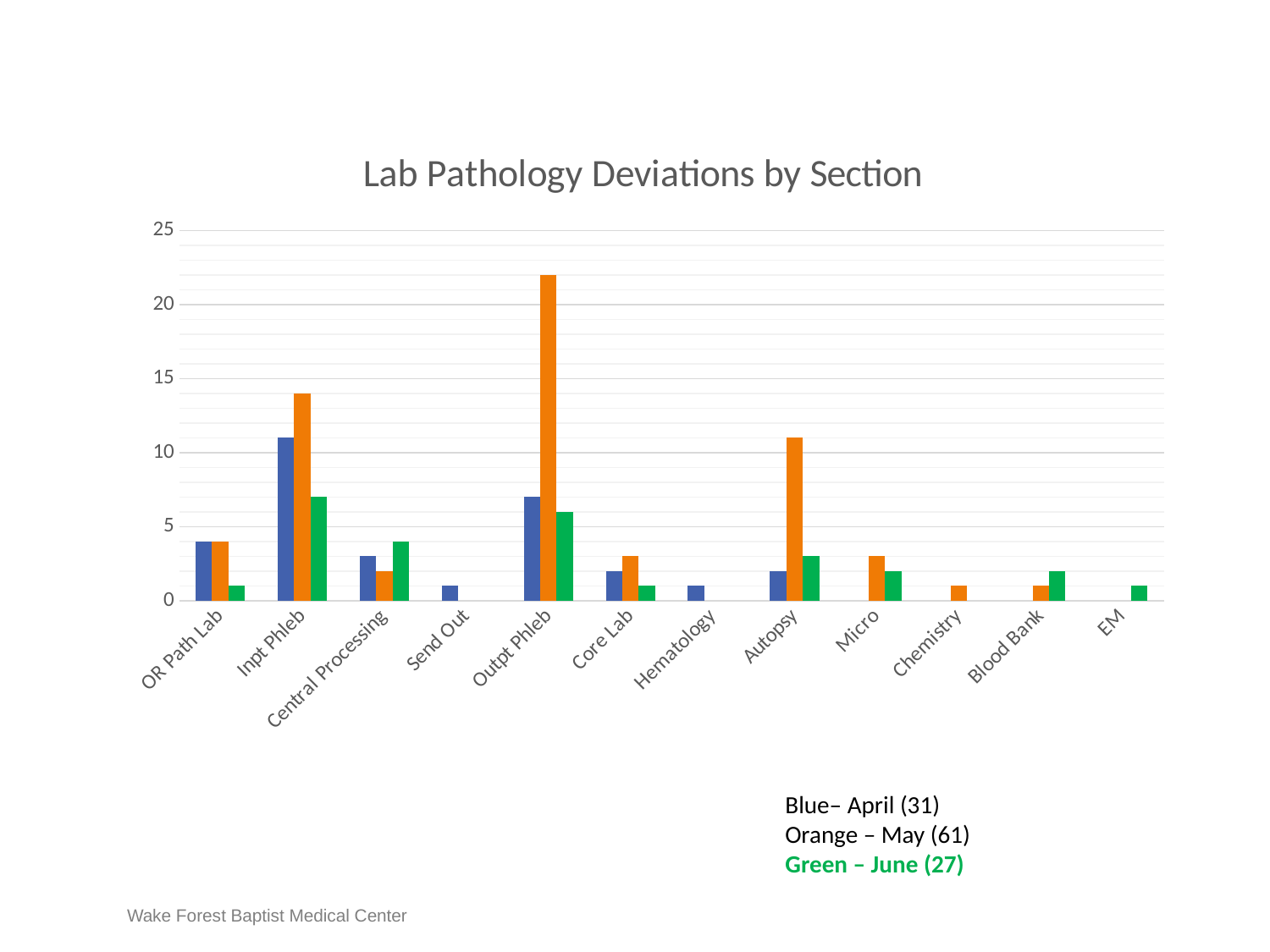
For April (blue), which section has the larger value: Inpt Phleb or Outpt Phleb? Inpt Phleb Which section has the highest blue (April) bar? Inpt Phleb According to the colour key, what total is given for May? 61 Is the May (orange) value for Autopsy greater or less than 5? greater How many months (series) does the colour key below the chart list? 3 For Central Processing, which is larger: the May (orange) bar or the June (green) bar? June (green) Is the May (orange) value for Inpt Phleb greater or less than 15? less What kind of chart is shown on the slide? bar chart Which section has the highest orange (May) bar? Outpt Phleb Is the May (orange) value for Outpt Phleb greater or less than 20? greater How many sections are shown along the x axis of the chart? 12